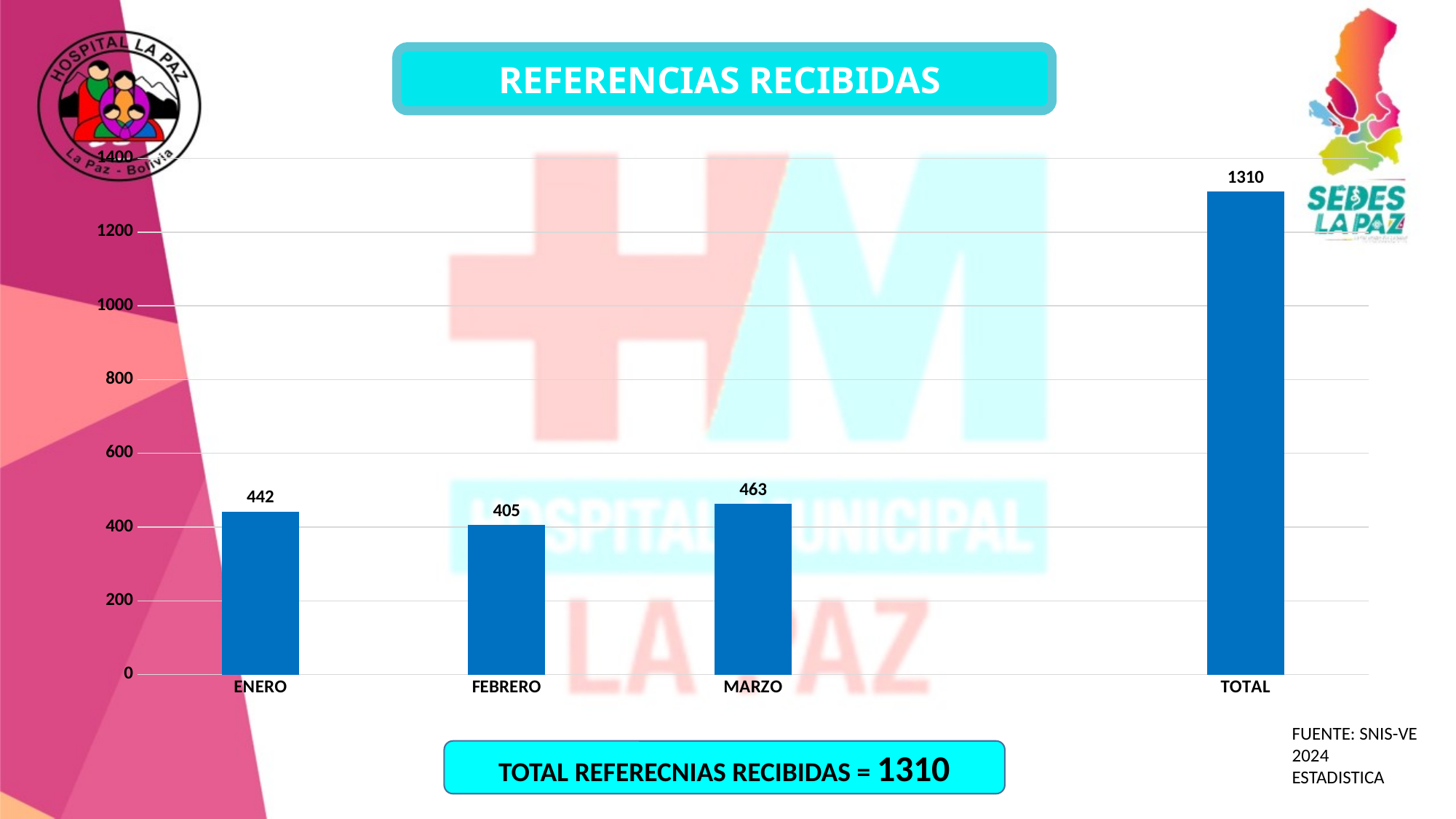
Among the three months (ENERO, FEBRERO, MARZO), which has the highest value? MARZO Which is larger, the value for ENERO or the value for FEBRERO? ENERO What is the value for TOTAL? 1310 What is the value for MARZO? 463 Which category has the lowest value? FEBRERO How many categories are shown on the x axis? 4 Is the value for MARZO greater or less than 400? greater What is the value for FEBRERO? 405 What kind of chart is shown on the slide? bar chart What is the title of the chart? REFERENCIAS RECIBIDAS What is the difference between the values for MARZO and FEBRERO? 58 What is the value for ENERO? 442